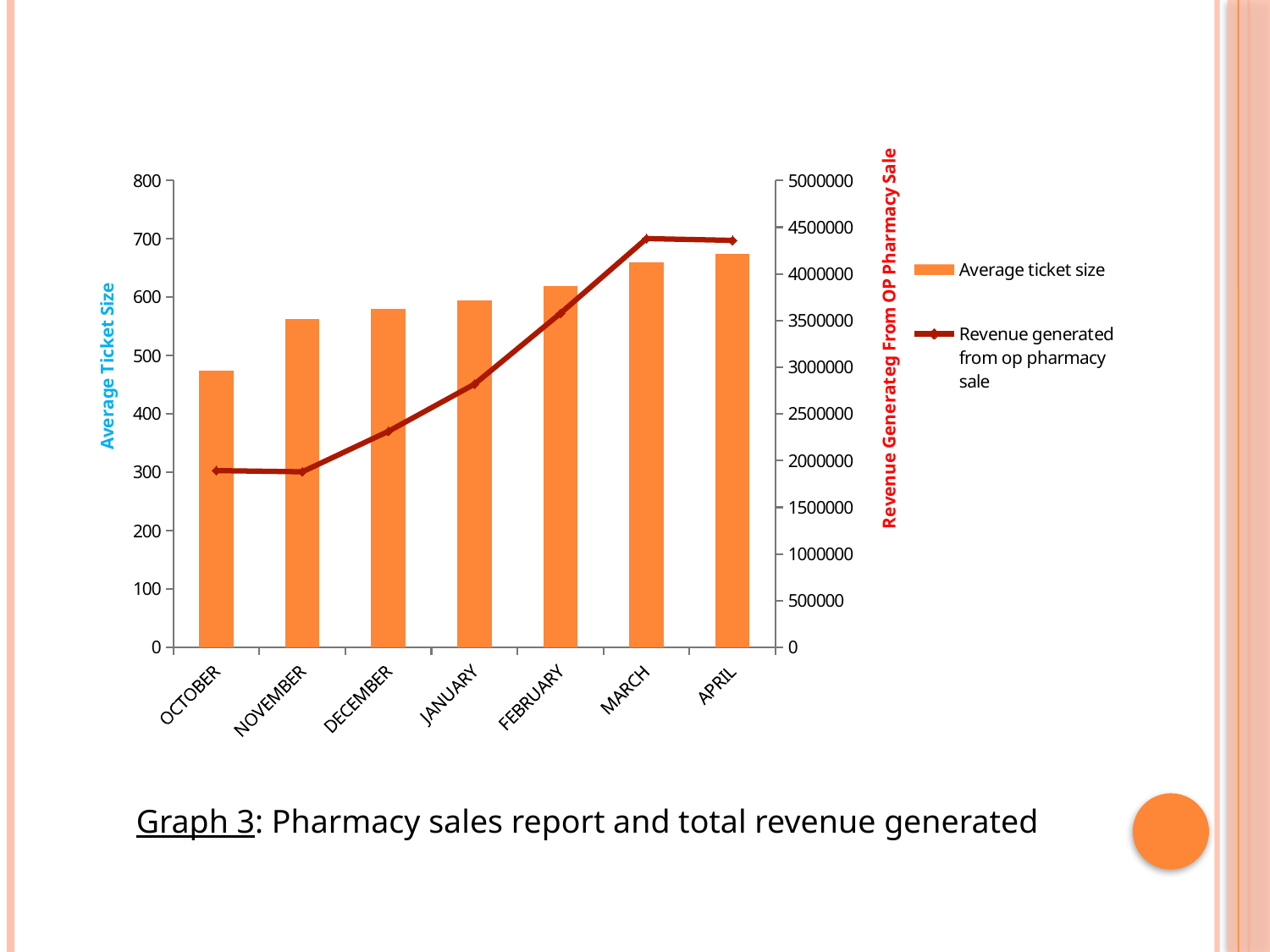
Is the revenue generated from op pharmacy sale in March greater or less than 4000000? greater Is the revenue generated from op pharmacy sale in February greater or less than 3000000? greater Is the average ticket size for March greater or less than 600? greater Do the average ticket size bars generally rise or fall from October to April? rise What is the title of the left vertical axis of the chart? Average Ticket Size Which is larger, the average ticket size for October or for March? March How many months are shown on the x axis of the chart? 7 What kind of chart is shown on the slide? A combination bar and line chart How many series does the chart's legend list? 2 Which month has the lowest average ticket size? October